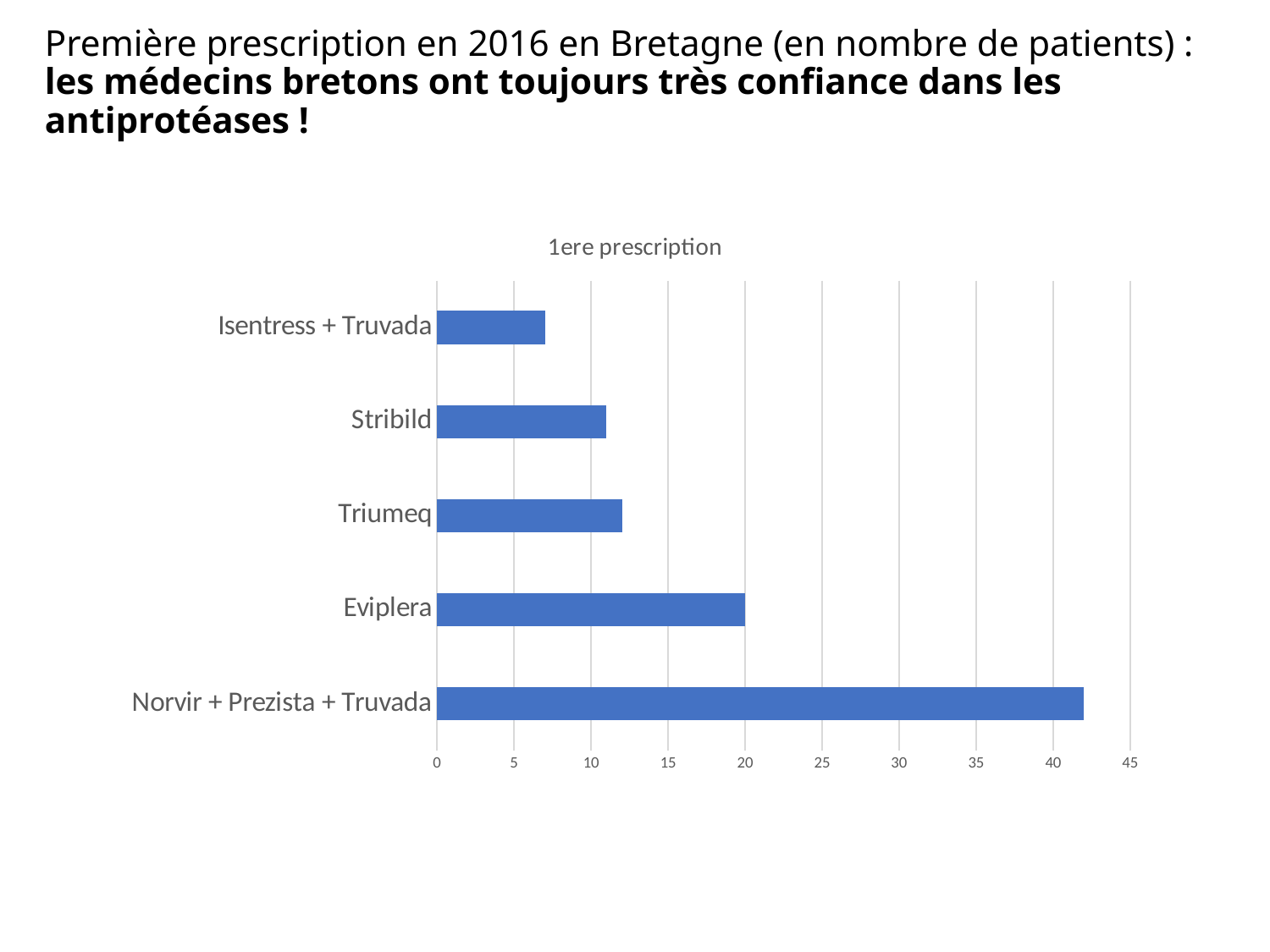
Is the value for Triumeq greater or less than 15? less Which has a larger value, Norvir + Prezista + Truvada or Eviplera? Norvir + Prezista + Truvada What is the title of the chart? 1ere prescription Which category has the lowest value? Isentress + Truvada Is the value for Isentress + Truvada greater or less than 10? less What is the value for Eviplera? 20 Is the value for Norvir + Prezista + Truvada greater or less than 40? greater Which has a larger value, Eviplera or Triumeq? Eviplera How many categories are shown in the chart? 5 What kind of chart is shown on the slide? bar chart Which category has the highest value? Norvir + Prezista + Truvada